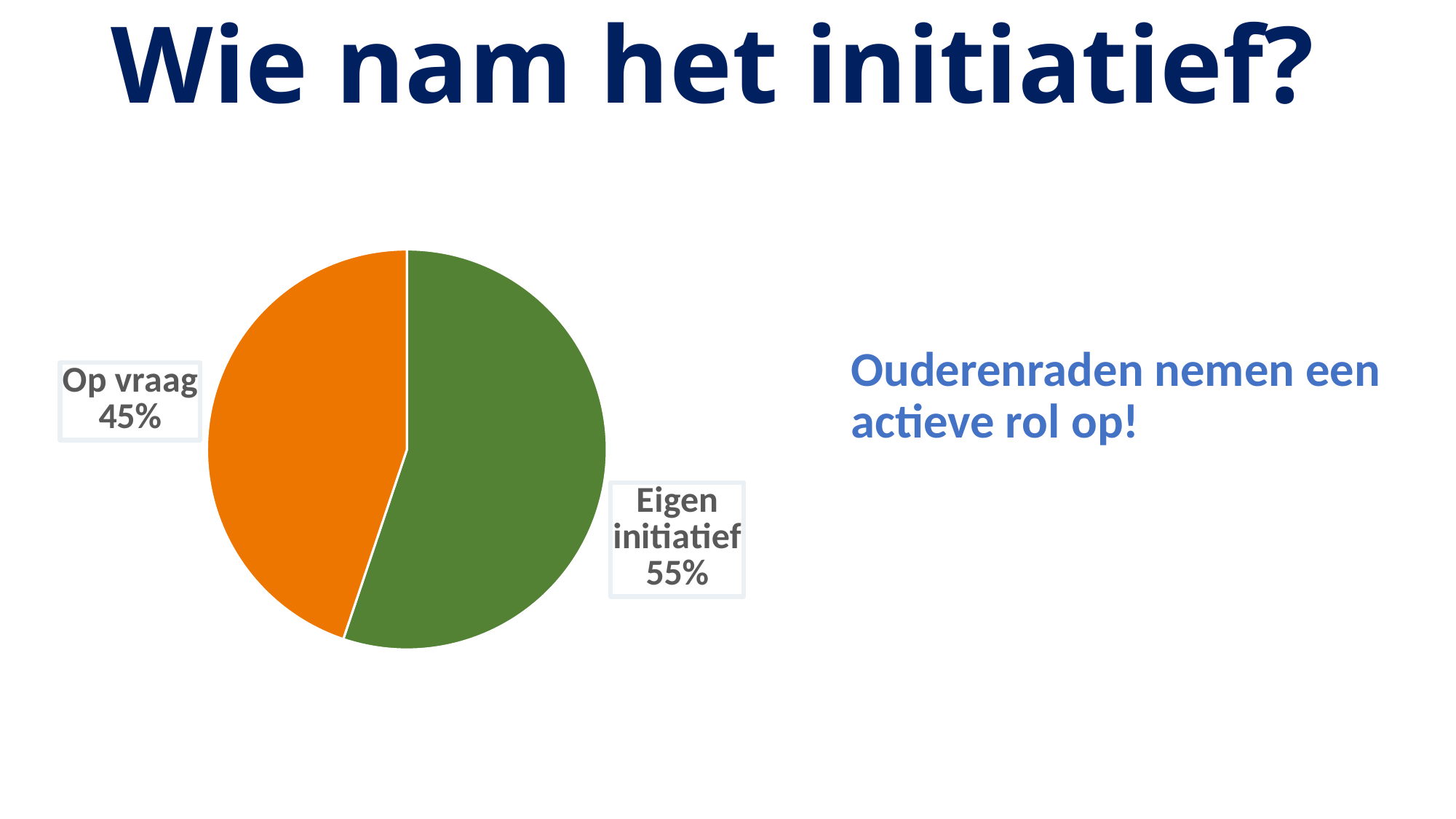
Which slice of the pie is the largest? Eigen initiatief What colour is the "Eigen initiatief" slice? Green What colour is the "Op vraag" slice? Orange What share of the pie does "Op vraag" represent? 45% What is the total of the two slices shown in the pie chart? 100% What is the difference in percentage points between "Eigen initiatief" and "Op vraag"? 10 percentage points How many slices does the pie chart have? 2 What share of the pie does "Eigen initiatief" represent? 55% Which slice of the pie is the smallest? Op vraag What kind of chart is shown on the slide? Pie chart Which is larger, "Op vraag" or "Eigen initiatief"? Eigen initiatief